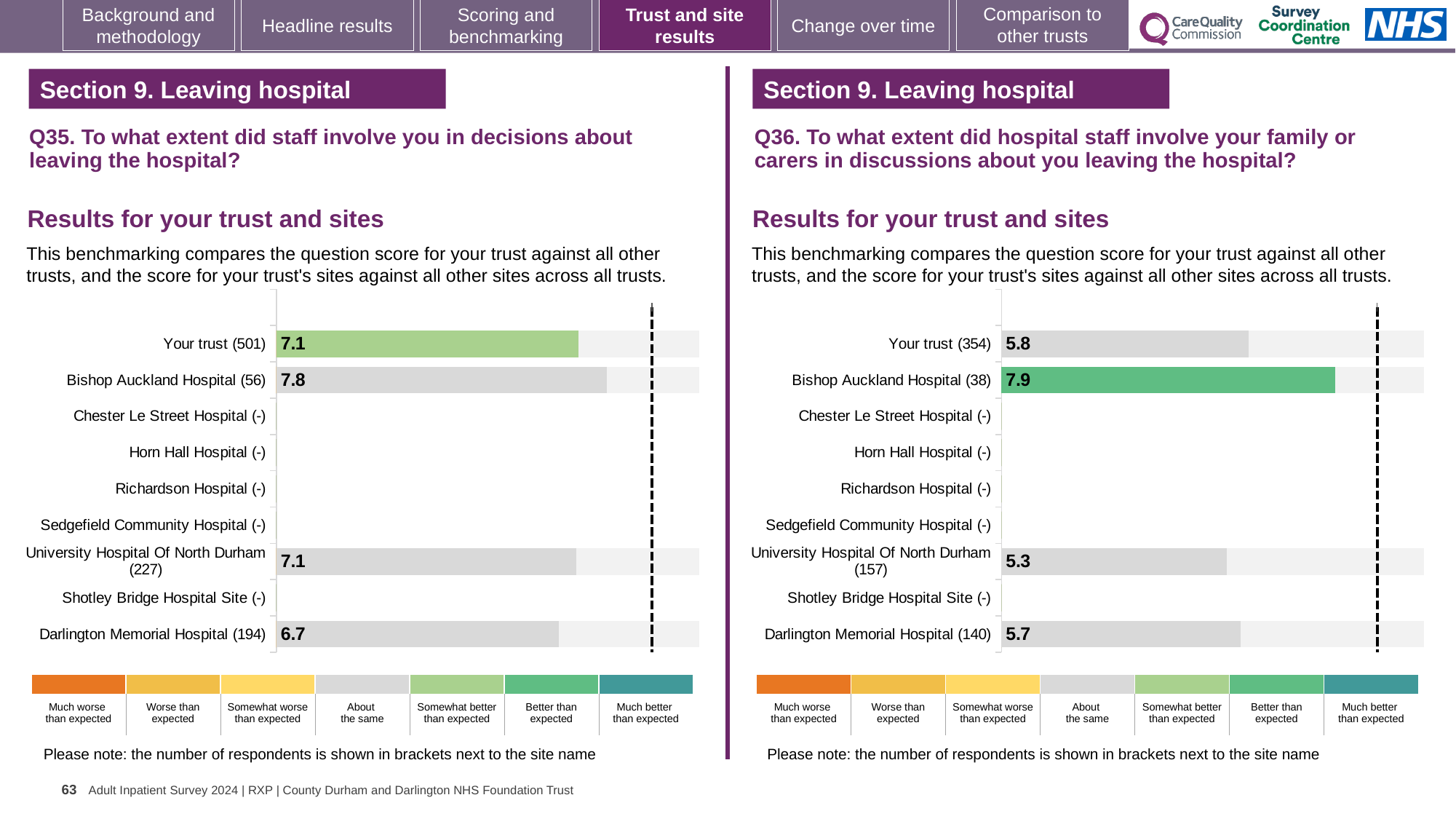
In the Q35 chart on the left, what is the difference between the scores for Bishop Auckland Hospital (56) and Darlington Memorial Hospital (194)? 1.1 In the Q36 chart on the right, what is the score for Your trust (354)? 5.8 In the Q36 chart on the right, which is larger: the score for Your trust (354) or Darlington Memorial Hospital (140)? Your trust (354) In the Q35 chart on the left, how many site or trust rows are listed on the vertical axis? 9 In the Q36 chart on the right, which site has the highest score? Bishop Auckland Hospital (38) In the Q36 chart on the right, which benchmark category does the green colour of the Bishop Auckland Hospital (38) bar correspond to in the legend? Better than expected In the Q36 chart on the right, what is the difference between the scores for Bishop Auckland Hospital (38) and University Hospital Of North Durham (157)? 2.6 In the Q35 chart on the left, what is the score for Bishop Auckland Hospital (56)? 7.8 In the Q36 chart on the right, what is the score for University Hospital Of North Durham (157)? 5.3 In the Q35 chart on the left, what is the score for Your trust (501)? 7.1 What kind of chart is used on the left for Q35? Bar chart In the Q35 chart on the left, which site has the lowest score? Darlington Memorial Hospital (194)